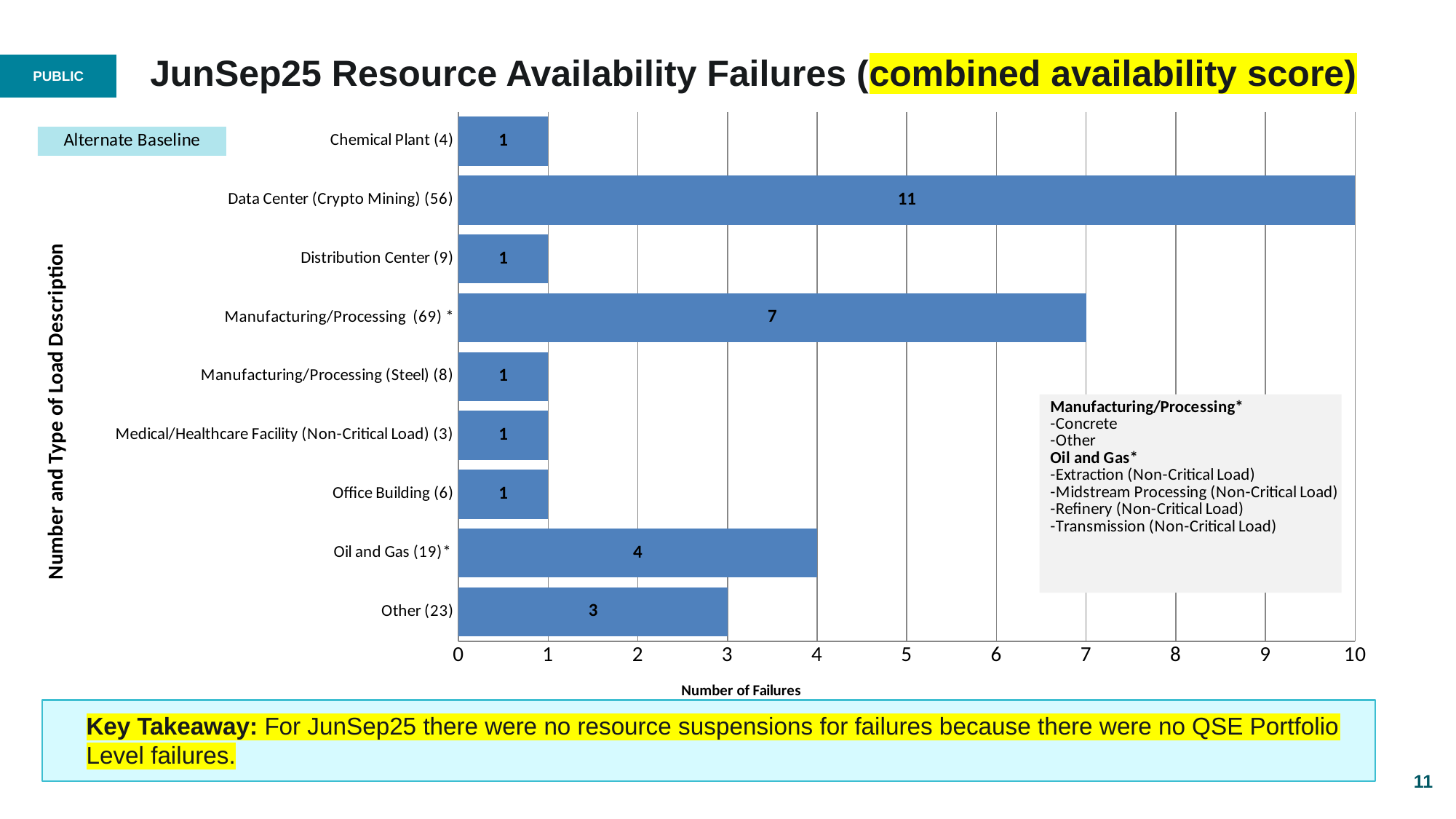
What is the number of failures for Manufacturing/Processing (69) *? 7 What is the difference in number of failures between Data Center (Crypto Mining) (56) and Manufacturing/Processing (69) *? 4 How many load description categories are shown on the chart? 9 What is the number of failures for Data Center (Crypto Mining) (56)? 11 Which has more failures, Oil and Gas (19)* or Other (23)? Oil and Gas (19)* What is the label of the y axis? Number and Type of Load Description How many categories have exactly 1 failure? 5 What is the number of failures for Other (23)? 3 Which load description category has the highest number of failures? Data Center (Crypto Mining) (56) What is the label of the x axis? Number of Failures What is the number of failures for Oil and Gas (19)*? 4 What kind of chart is shown on the slide? Bar chart